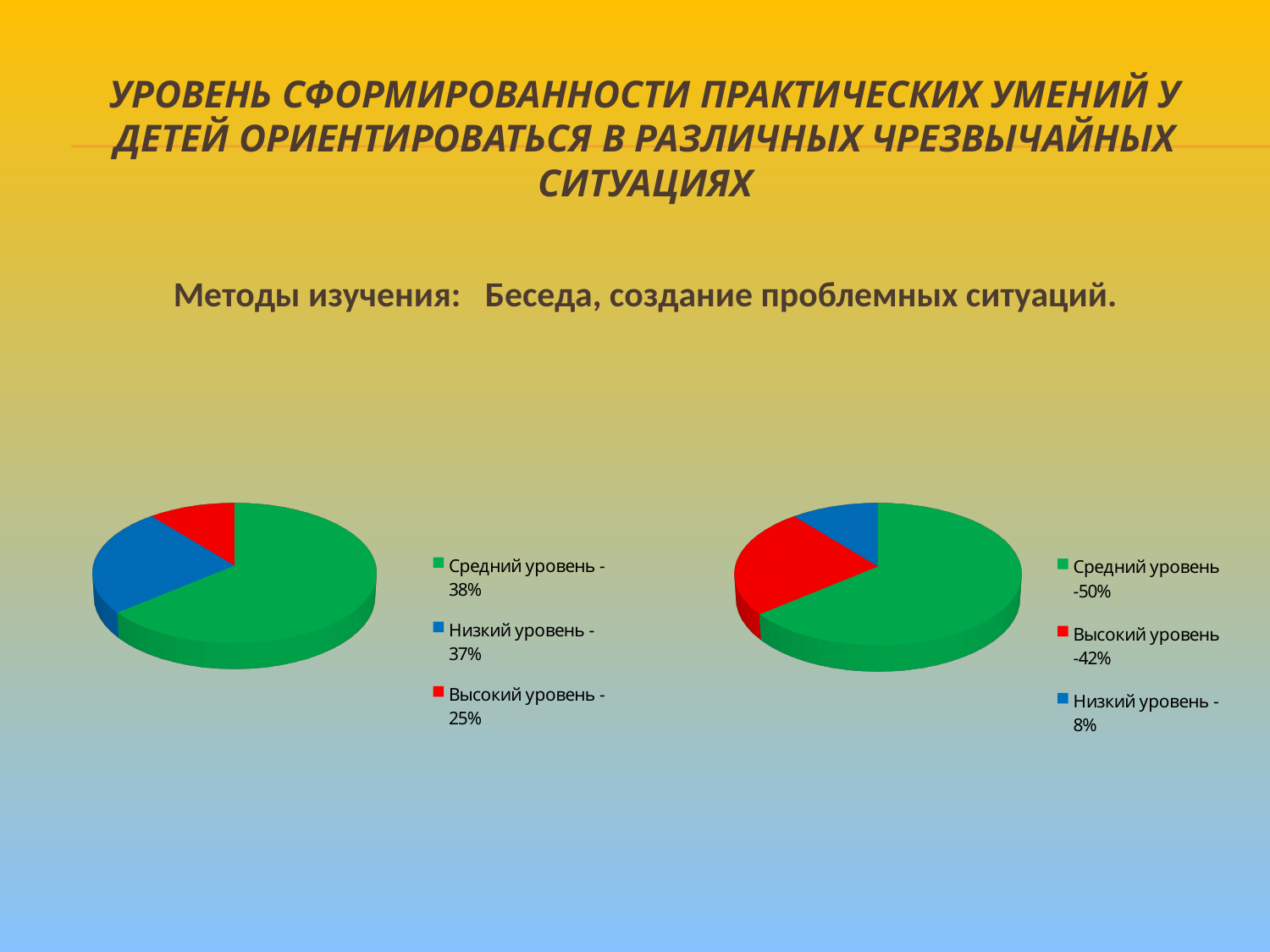
In the left pie chart, which category has the smallest share? Высокий уровень In the right pie chart, what is the difference between the shares of Средний уровень and Высокий уровень? 8% What type of chart is shown on the left of the slide? pie chart In the right pie chart, what share is shown for Низкий уровень? 8% In the right pie chart, which category has the largest share? Средний уровень In the left pie chart, what share is shown for Средний уровень? 38% How many categories does the legend of the left pie chart list? 3 In the right pie chart, which colour represents Высокий уровень? red In the left pie chart, what share is shown for Высокий уровень? 25% In the right pie chart, which category has the smallest share? Низкий уровень In the right pie chart, what share is shown for Высокий уровень? 42% In the left pie chart, what is the difference between the shares of Средний уровень and Высокий уровень? 13%